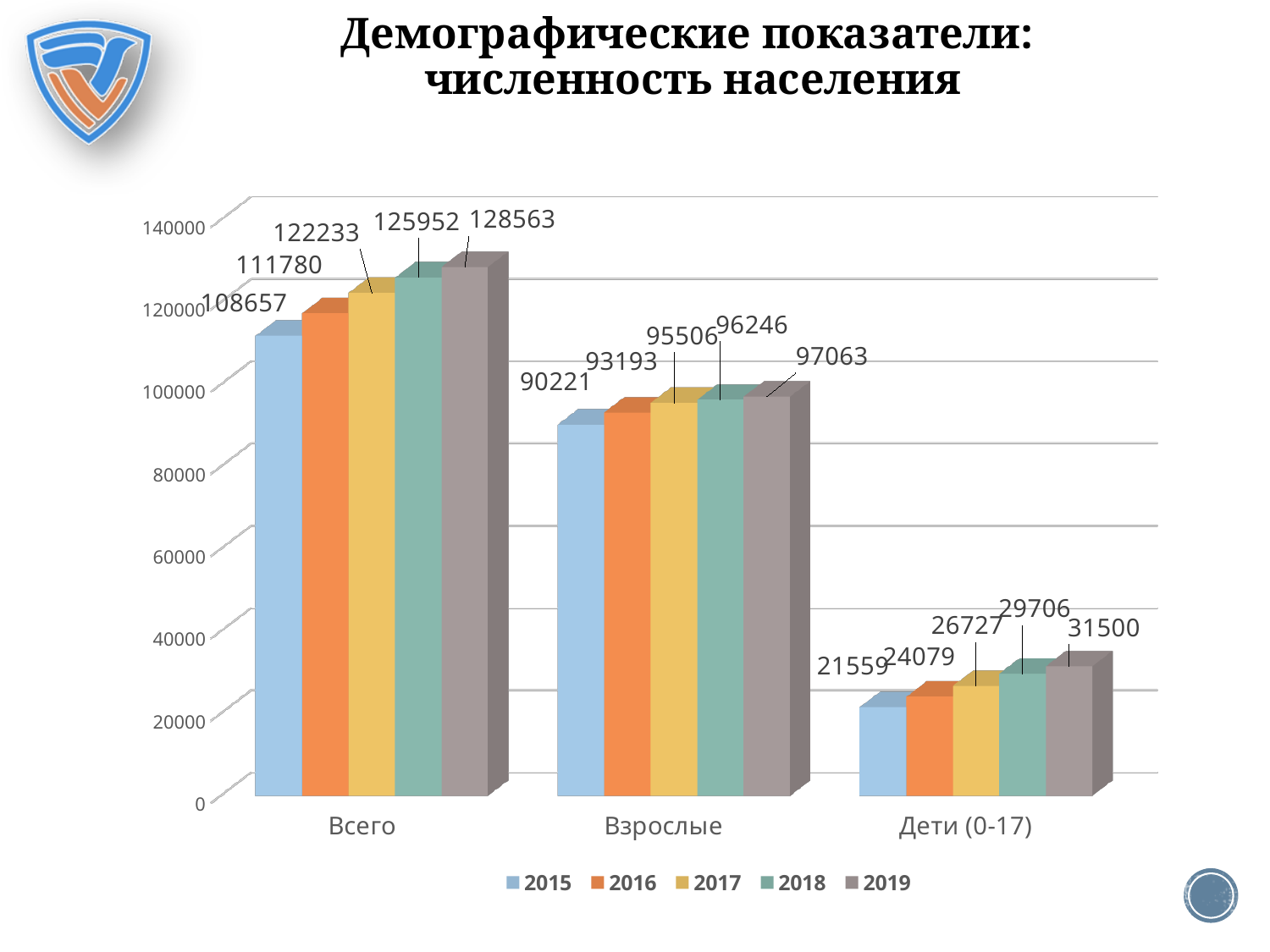
What is the value for Дети (0-17) in 2017? 26727 What is the value for Всего in 2019? 128563 What kind of chart is shown on the slide? Bar chart Do the values for Взрослые rise or fall from 2015 to 2019? Rise How many categories are shown on the x axis? 3 What is the difference between the 2019 and 2018 values for Дети (0-17)? 1794 What is the value for Взрослые in 2015? 90221 Which year has the lowest value for Всего? 2015 How many series does the legend list? 5 Which year has the highest value for Дети (0-17)? 2019 Which is larger: the 2016 value for Взрослые or the 2016 value for Дети (0-17)? Взрослые What is the difference between the 2019 and 2015 values for Всего? 16783